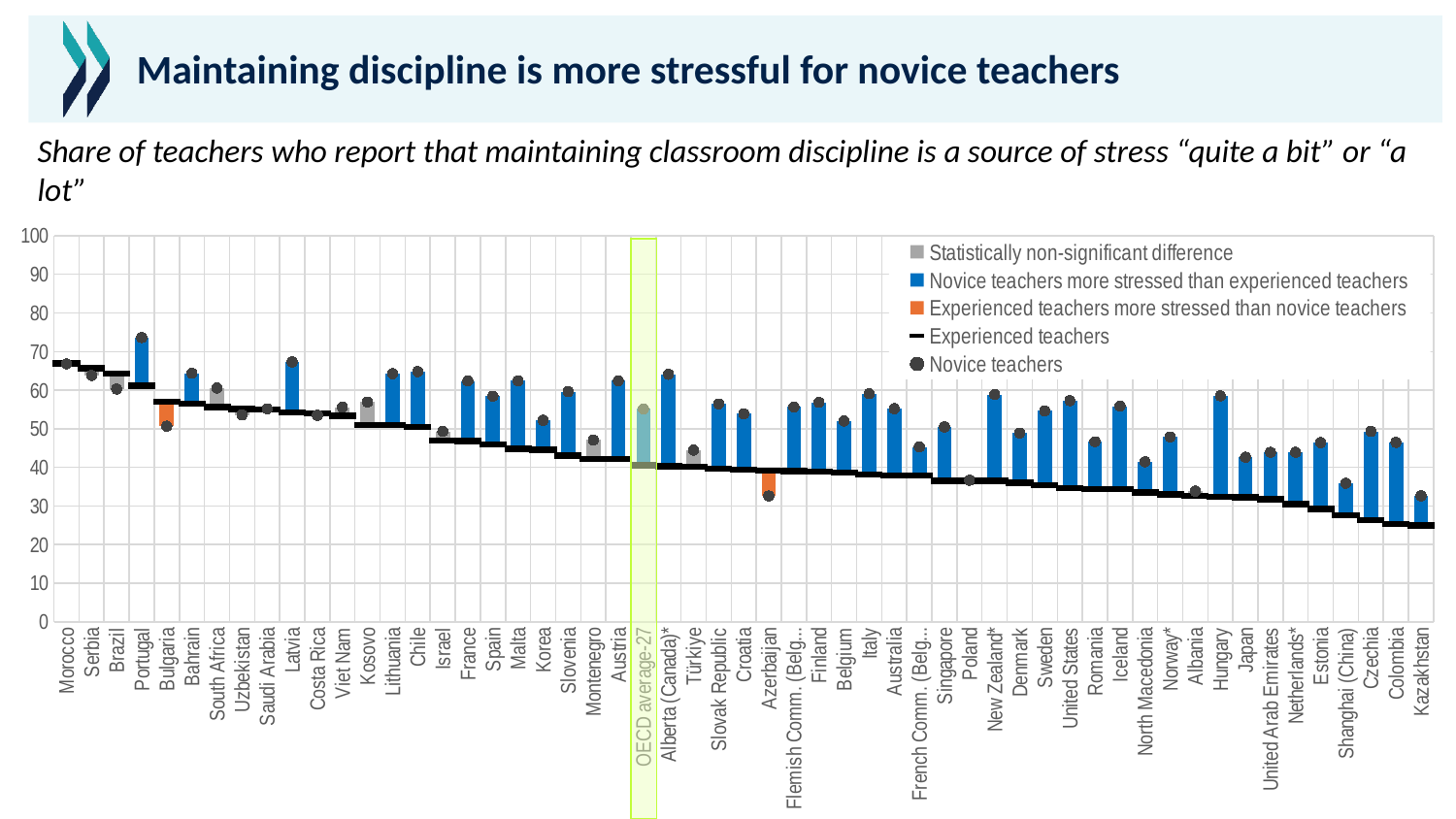
Which country has the lowest value for experienced teachers? Kazakhstan Is the value for experienced teachers in Kazakhstan greater or less than 30? less What kind of chart is shown on the slide? bar chart Which category on the x axis is highlighted with a shaded box? OECD average-27 How many entries does the legend list? 5 How many countries show experienced teachers more stressed than novice teachers (orange bars)? 2 Which is larger, the novice teachers value for Portugal or for Kazakhstan? Portugal Is the value for novice teachers in Portugal greater or less than 70? greater Is the value for novice teachers in Azerbaijan greater or less than 40? less Do the values for experienced teachers rise or fall from left to right along the x axis? fall Which country has the highest value for novice teachers? Portugal